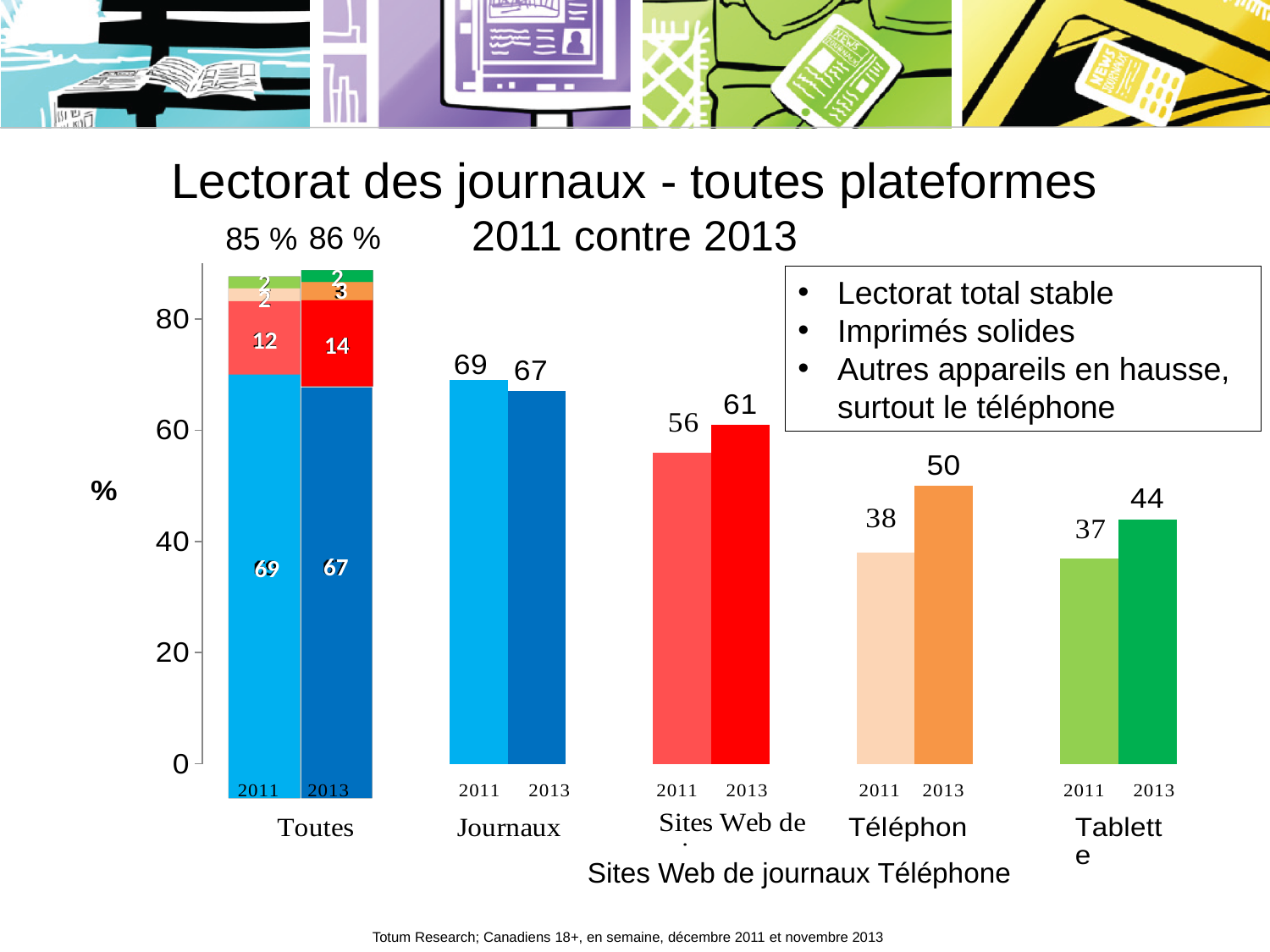
What is the value for Journaux in 2011? 69 What is the value for Sites Web de journaux in 2013? 61 What is the value for Téléphone in 2013? 50 What is the difference between the 2013 and 2011 values for Téléphone? 12 What is the title of the chart? Lectorat des journaux - toutes plateformes 2011 contre 2013 What is the value for Tablette in 2011? 37 What kind of chart is shown on the slide? bar chart Among the 2013 bars for Journaux, Sites Web de journaux, Téléphone and Tablette, which category has the lowest value? Tablette What is the total of the stacked bar for Toutes in 2013? 86 % Is the 2011 value for Sites Web de journaux greater or less than 60? less Among the 2011 bars for Journaux, Sites Web de journaux, Téléphone and Tablette, which category has the highest value? Journaux Which is larger for Tablette: the 2011 value or the 2013 value? 2013